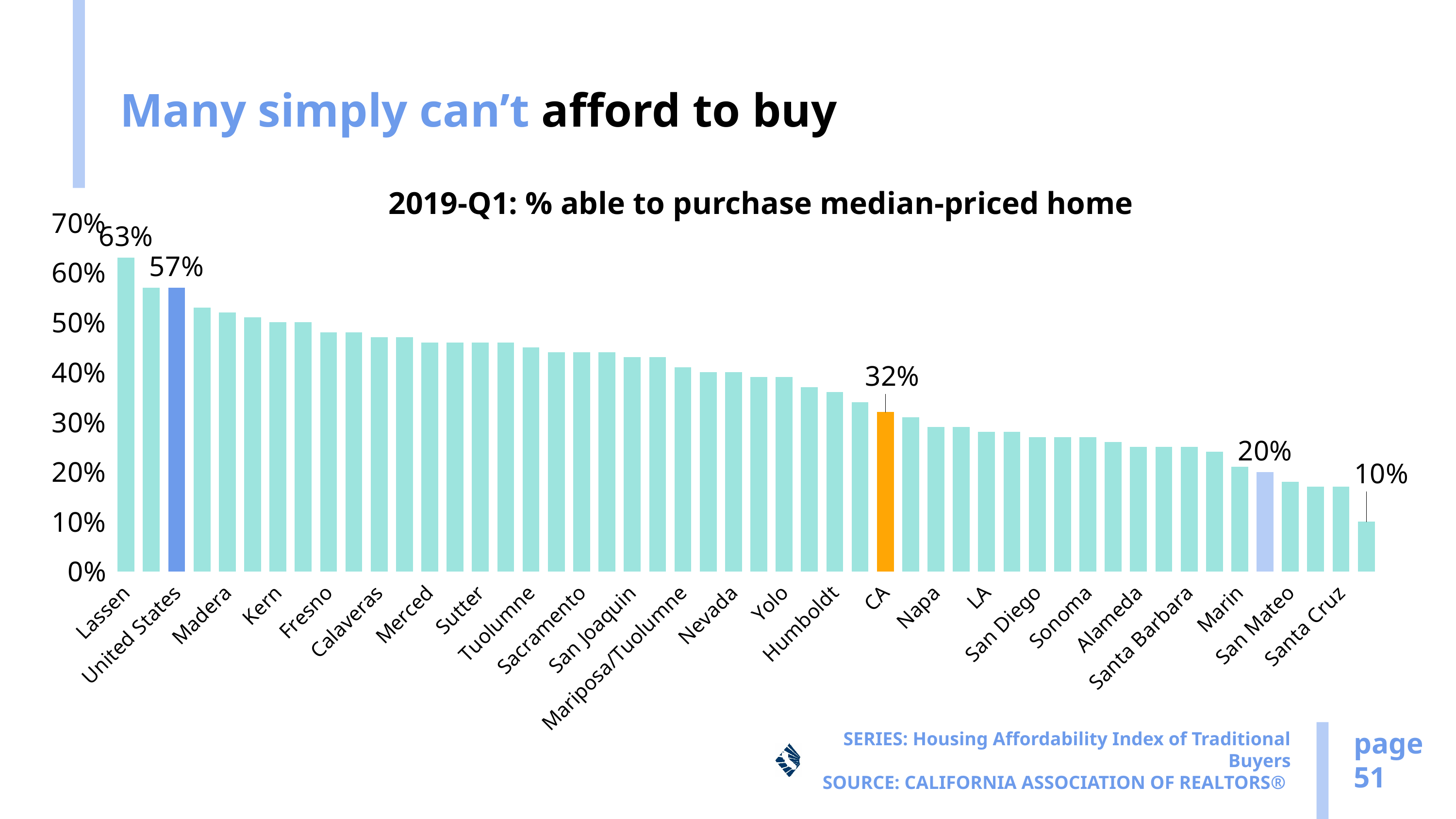
What type of chart is shown on the slide? bar chart What is the chart's title? 2019-Q1: % able to purchase median-priced home Which category has the highest value? Lassen What is the value for Lassen? 63% Is the value for Kern greater or less than 40%? greater What is the value for the United States? 57% What is the value of the shortest bar on the chart? 10% What is the difference between the United States value and the CA value? 25 percentage points Which is larger, the value for the United States or the value for CA? United States What is the value for CA? 32% Do the values rise or fall moving from left to right along the x axis? fall